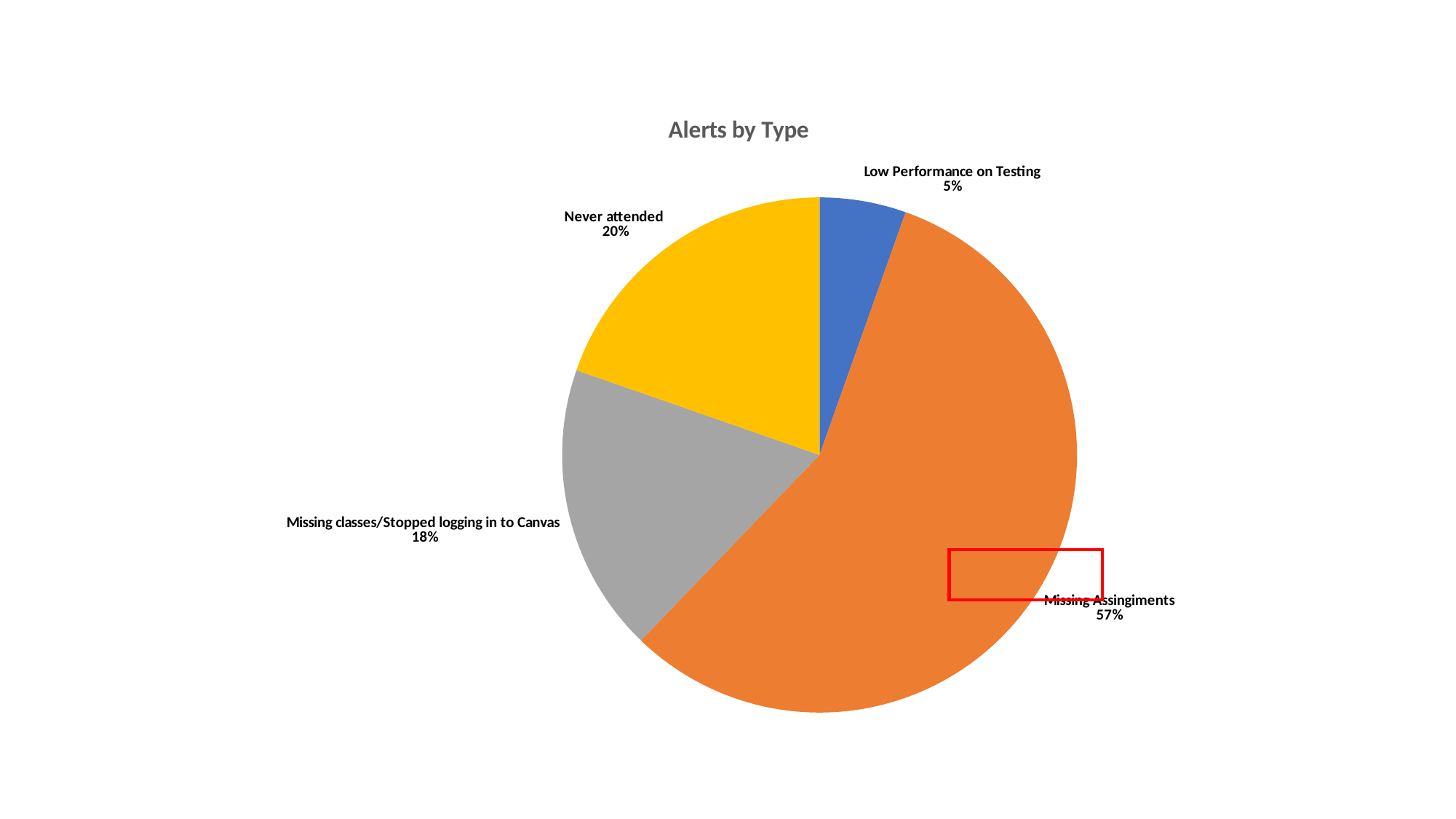
Which alert type has the smallest share? Low Performance on Testing What colour is the Missing Assingiments slice? Orange What kind of chart is shown on the slide? Pie chart Which is larger, Never attended or Missing classes/Stopped logging in to Canvas? Never attended Which alert type has the largest share? Missing Assingiments What share of alerts is Missing Assingiments? 57% How many slices does the pie chart have? 4 What share of alerts is Missing classes/Stopped logging in to Canvas? 18% What share of alerts is Never attended? 20% What is the title of the chart? Alerts by Type What is the difference in percentage points between Missing Assingiments and Never attended? 37